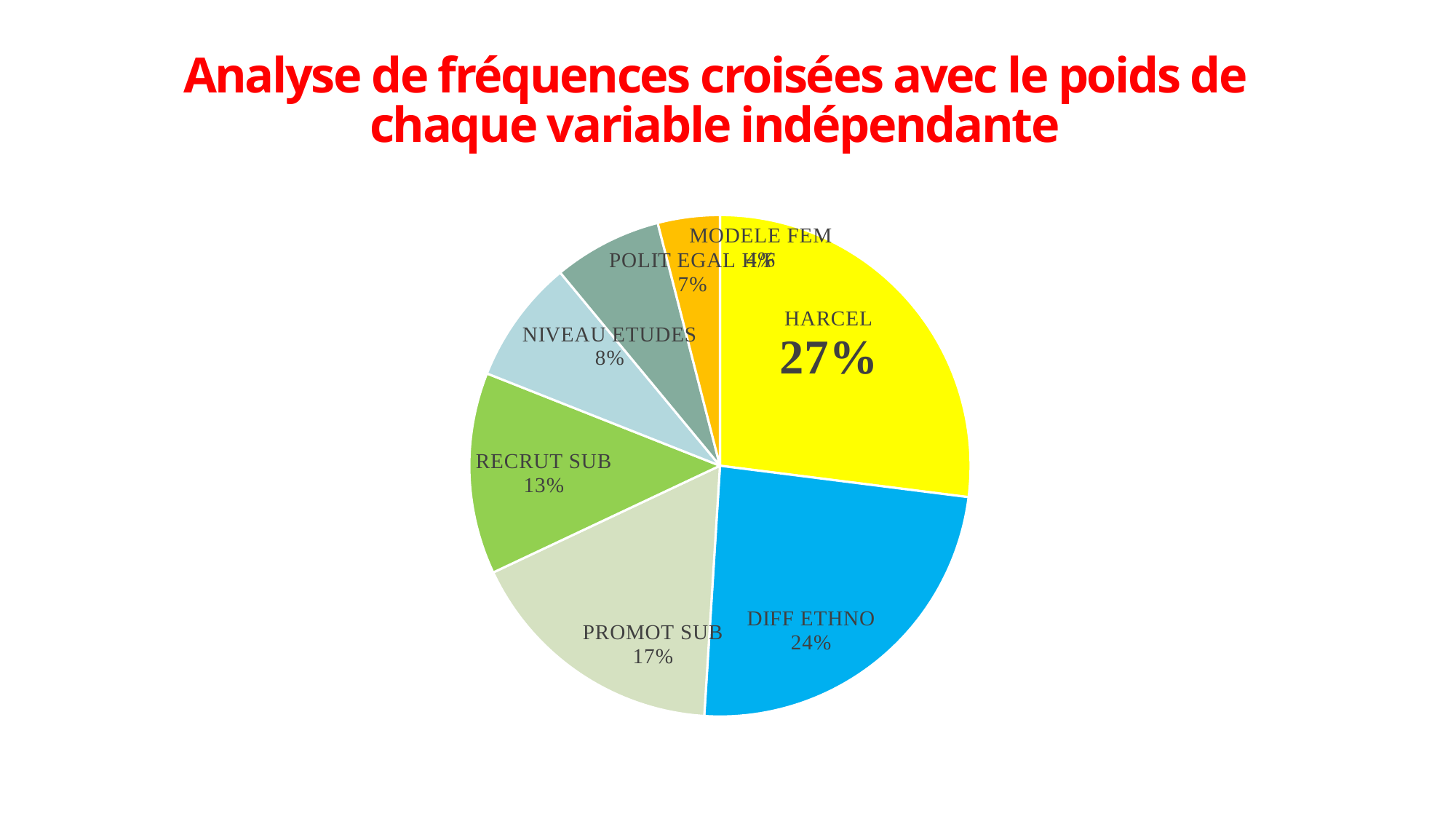
What type of chart is shown on the slide? pie chart What is the difference between the HARCEL and DIFF ETHNO percentages? 3% What percentage does the HARCEL slice represent? 27% What is the value shown for DIFF ETHNO? 24% Which is larger, PROMOT SUB or RECRUT SUB? PROMOT SUB What percentage is shown for PROMOT SUB? 17% What is the value for RECRUT SUB? 13% Which category has the largest slice of the pie? HARCEL What colour is the HARCEL slice? yellow Which category has the smallest slice of the pie? MODELE FEM How many slices does the pie chart have? 7 What percentage is shown for NIVEAU ETUDES? 8%